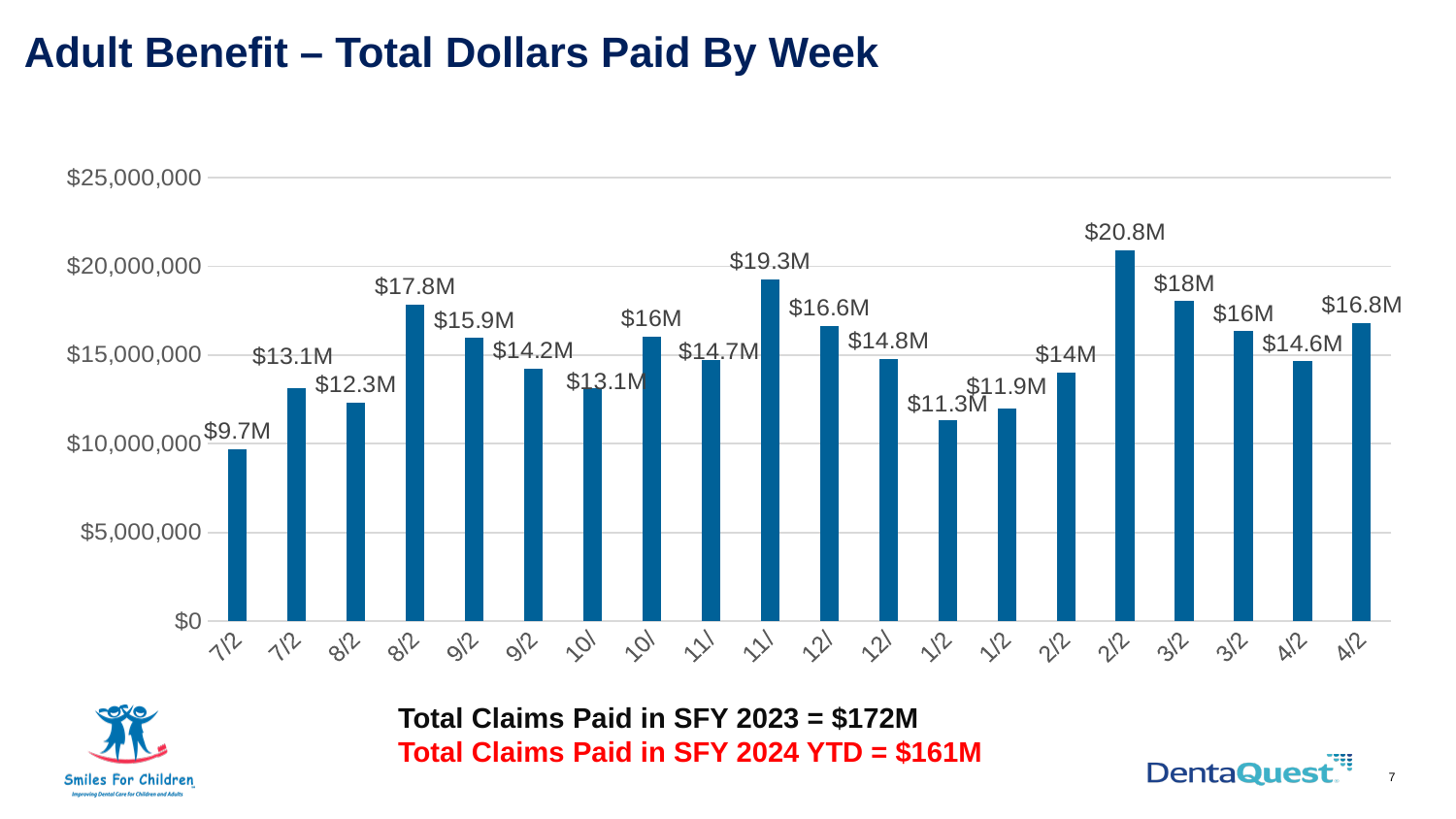
What is the lowest weekly value shown in the chart? $9.7M What is the value of the last (rightmost) bar in the chart? $16.8M What is the value of the first (leftmost) bar in the chart? $9.7M Which is larger, the first bar or the last bar in the chart? the last bar What is the value of the fourth bar from the left in the chart? $17.8M How many bars are plotted in the chart? 20 What is the highest weekly value shown in the chart? $20.8M Is the value of the tallest bar greater or less than $20,000,000? greater What is the title of the slide containing the chart? Adult Benefit – Total Dollars Paid By Week What is the difference between the highest and lowest bar values in the chart? $11.2M What is the difference between the last bar ($16.8M) and the first bar ($9.7M)? $7.1M What type of chart is shown on the slide? bar chart